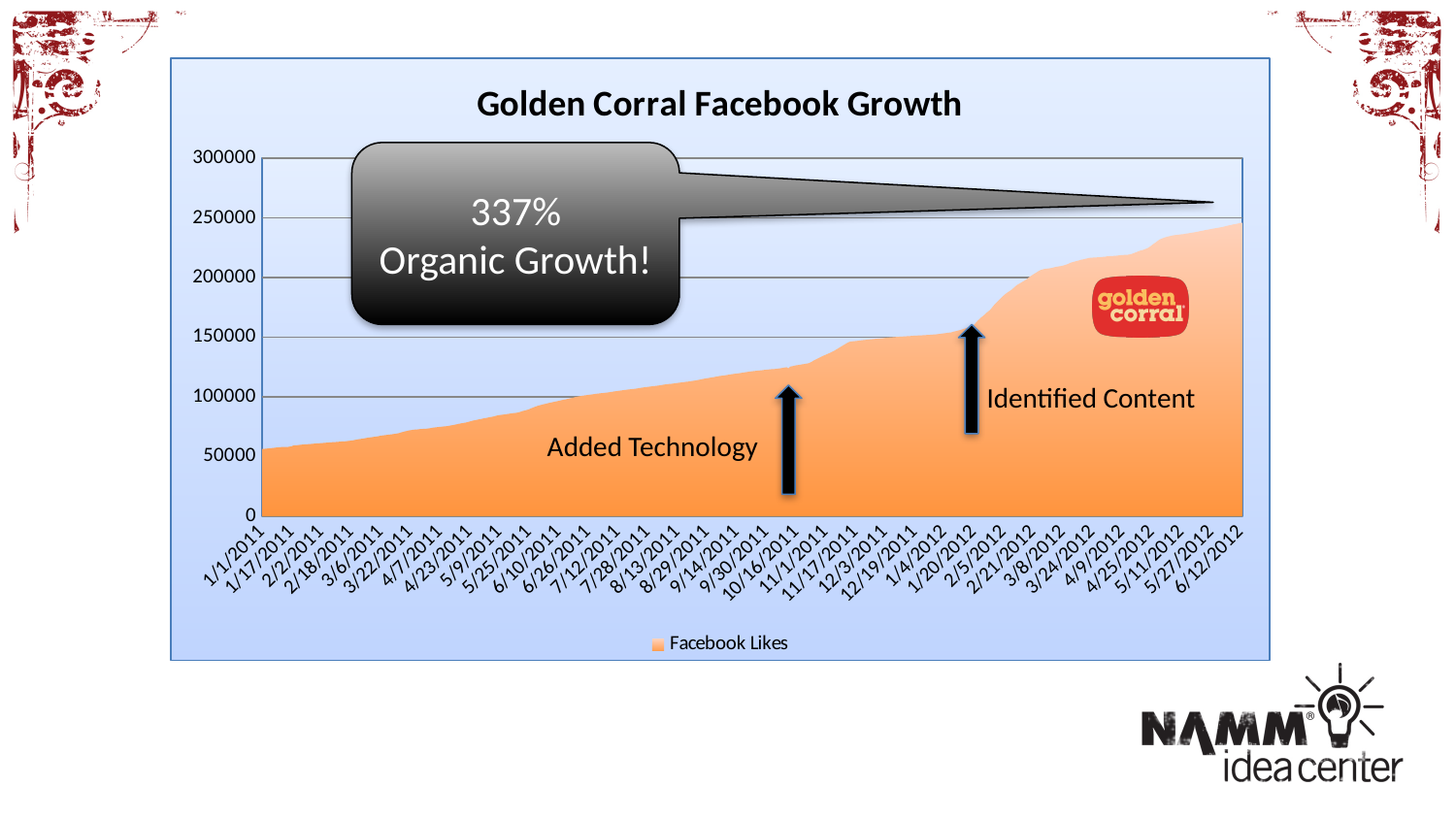
Do the Facebook Likes values rise or fall from 1/1/2011 to 6/12/2012? Rise Which date has the highest Facebook Likes value, 1/1/2011 or 6/12/2012? 6/12/2012 Is the value for 6/12/2012 greater or less than 200000? greater Is the value for 6/10/2011 greater or less than 150000? less How many series does the legend list? 1 Is the value for 2/5/2012 greater or less than 100000? greater How many date labels are shown on the x axis? 34 What is the title of the chart? Golden Corral Facebook Growth What series name appears in the legend? Facebook Likes What kind of chart is shown on the slide? Area chart